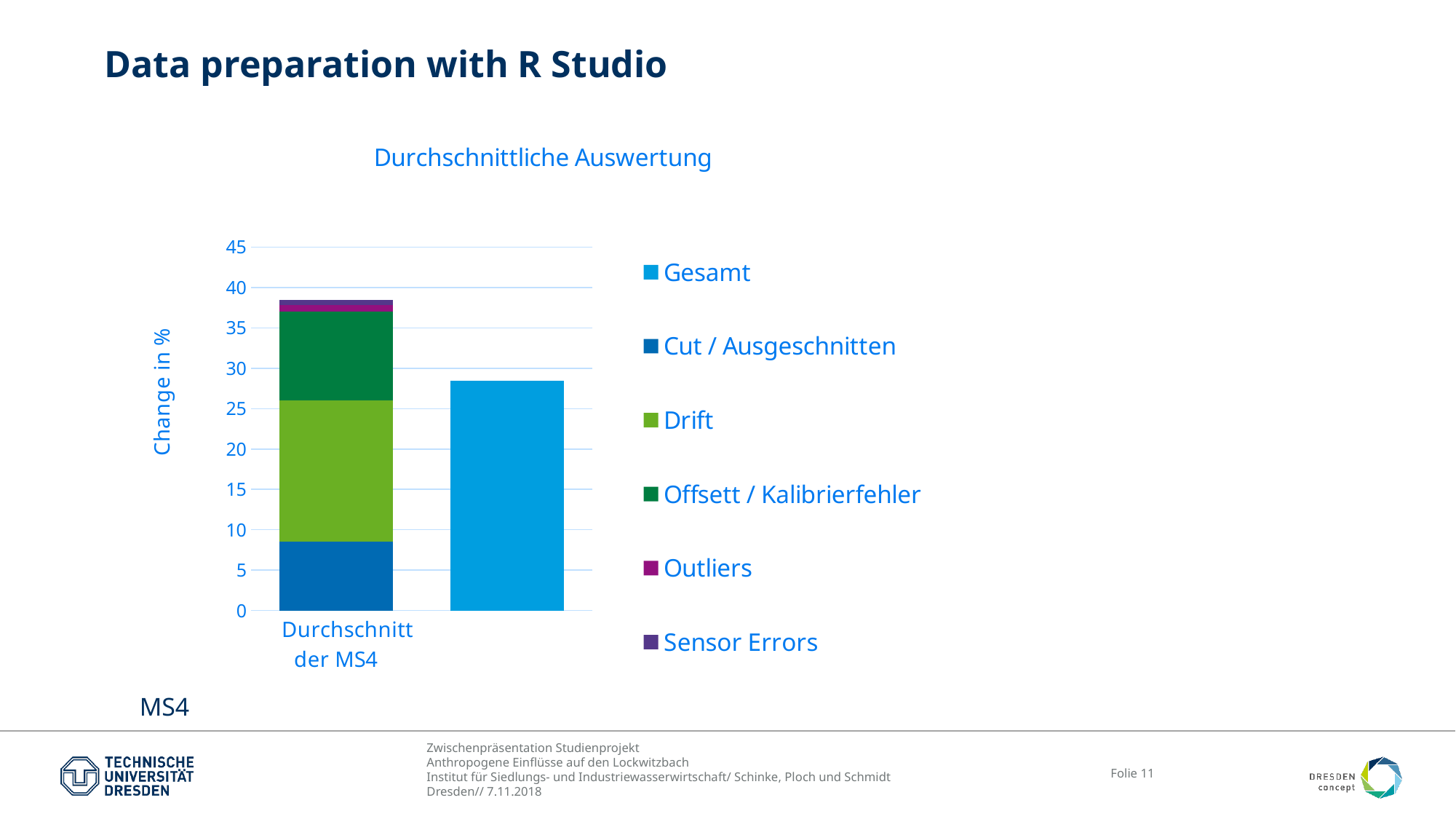
What kind of chart is shown on the slide? bar chart Which segment is larger in the stacked bar: Drift or Offsett / Kalibrierfehler? Drift Which is taller: the stacked bar for Durchschnitt der MS4 or the Gesamt bar? the stacked bar for Durchschnitt der MS4 How many series does the chart's legend list? 6 Is the total height of the stacked bar for Durchschnitt der MS4 greater or less than 35? greater Is the Cut / Ausgeschnitten segment of the stacked bar greater or less than 10? less Is the value of the Gesamt bar greater or less than 25? greater What is the label of the chart's vertical axis? Change in % What is the title of the chart? Durchschnittliche Auswertung Which segment is the largest in the stacked bar for Durchschnitt der MS4? Drift